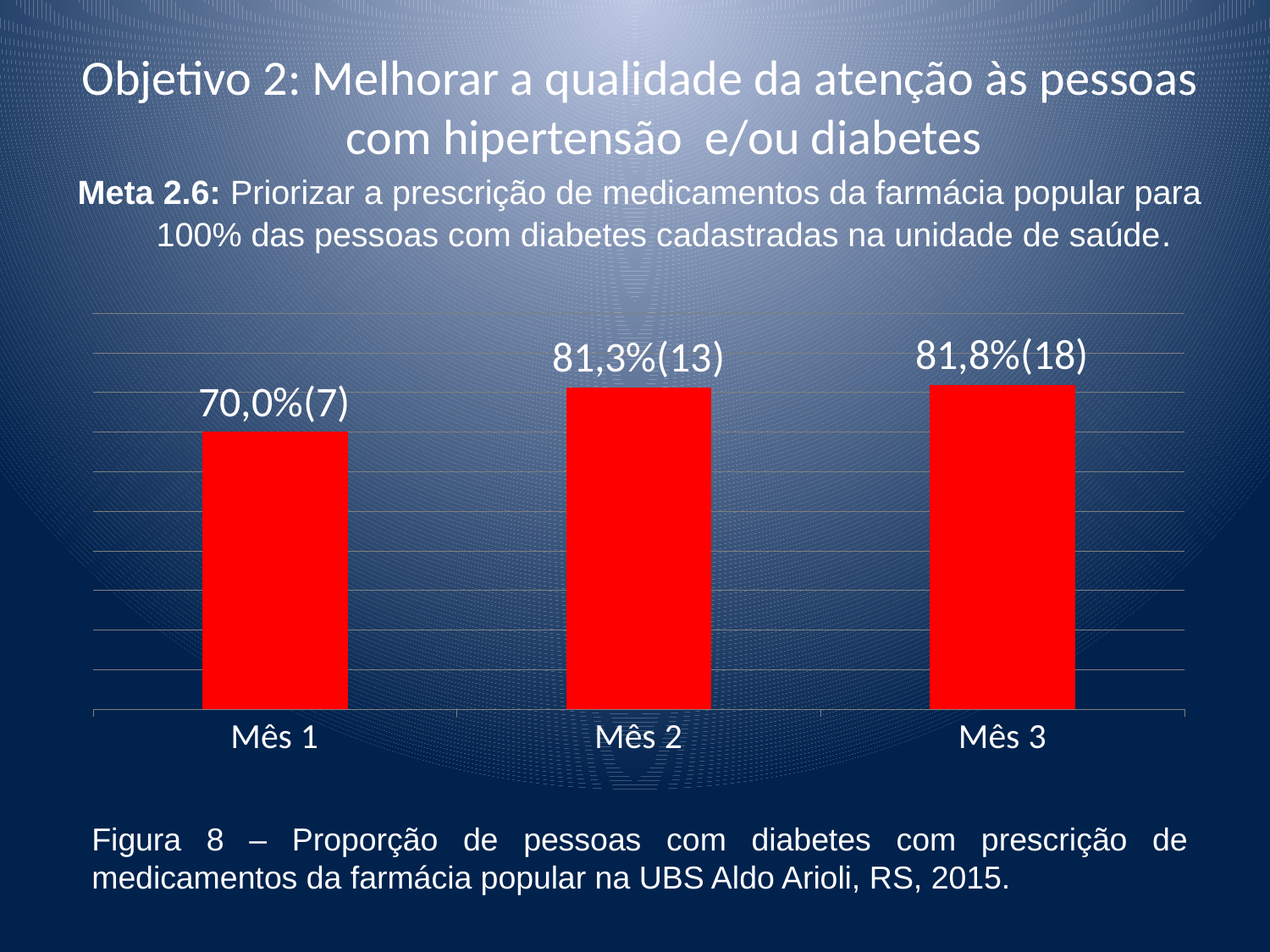
How many bars (categories) does the chart show? 3 Do the values rise or fall from Mês 1 to Mês 3? Rise Is the proportion for Mês 2 larger or smaller than for Mês 1? Larger What is the value shown for Mês 1? 70,0%(7) What colour are the bars in the chart? Red What kind of chart is shown on the slide? Bar chart What is the value shown for Mês 2? 81,3%(13) How many more people are counted in Mês 3 (18) than in Mês 1 (7)? 11 What is the difference in percentage points between Mês 2 (81,3%) and Mês 1 (70,0%)? 11,3 percentage points What is the value shown for Mês 3? 81,8%(18) Which month has the lowest proportion? Mês 1 Which month has the highest proportion according to the data labels? Mês 3